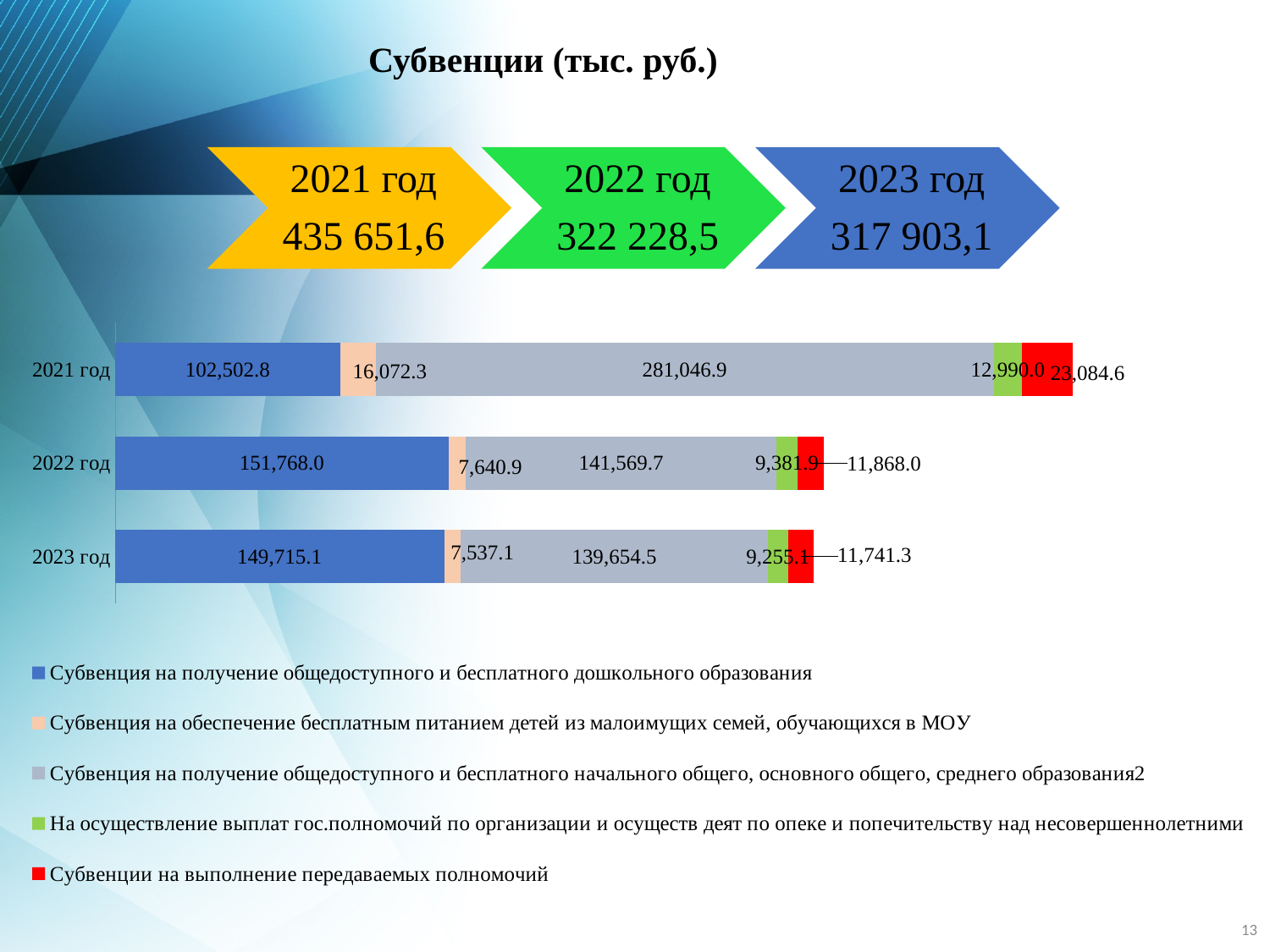
What kind of chart is shown on the slide? Stacked bar chart What is the total of the stacked bar for 2023 год? 317,903.1 In which year is the value for 'Субвенция на получение общедоступного и бесплатного дошкольного образования' lowest? 2021 год How many years (categories) are plotted in the chart? 3 In which year is the value for 'Субвенция на получение общедоступного и бесплатного начального общего, основного общего, среднего образования2' highest? 2021 год How many series does the chart legend list? 5 What is the value for 'Субвенция на получение общедоступного и бесплатного дошкольного образования' in 2021 год? 102,502.8 Which is larger in 2023 год: 'Субвенция на получение общедоступного и бесплатного дошкольного образования' or 'Субвенция на получение общедоступного и бесплатного начального общего, основного общего, среднего образования2'? Субвенция на получение общедоступного и бесплатного дошкольного образования By how much did 'Субвенция на получение общедоступного и бесплатного дошкольного образования' increase from 2021 год to 2022 год? 49,265.2 What is the value for 'Субвенции на выполнение передаваемых полномочий' in 2023 год? 11,741.3 What is the value for 'Субвенция на обеспечение бесплатным питанием детей из малоимущих семей, обучающихся в МОУ' in 2022 год? 7,640.9 What is the value for 'На осуществление выплат гос.полномочий по организации и осуществ деят по опеке и попечительству над несовершеннолетними' in 2021 год? 12,990.0